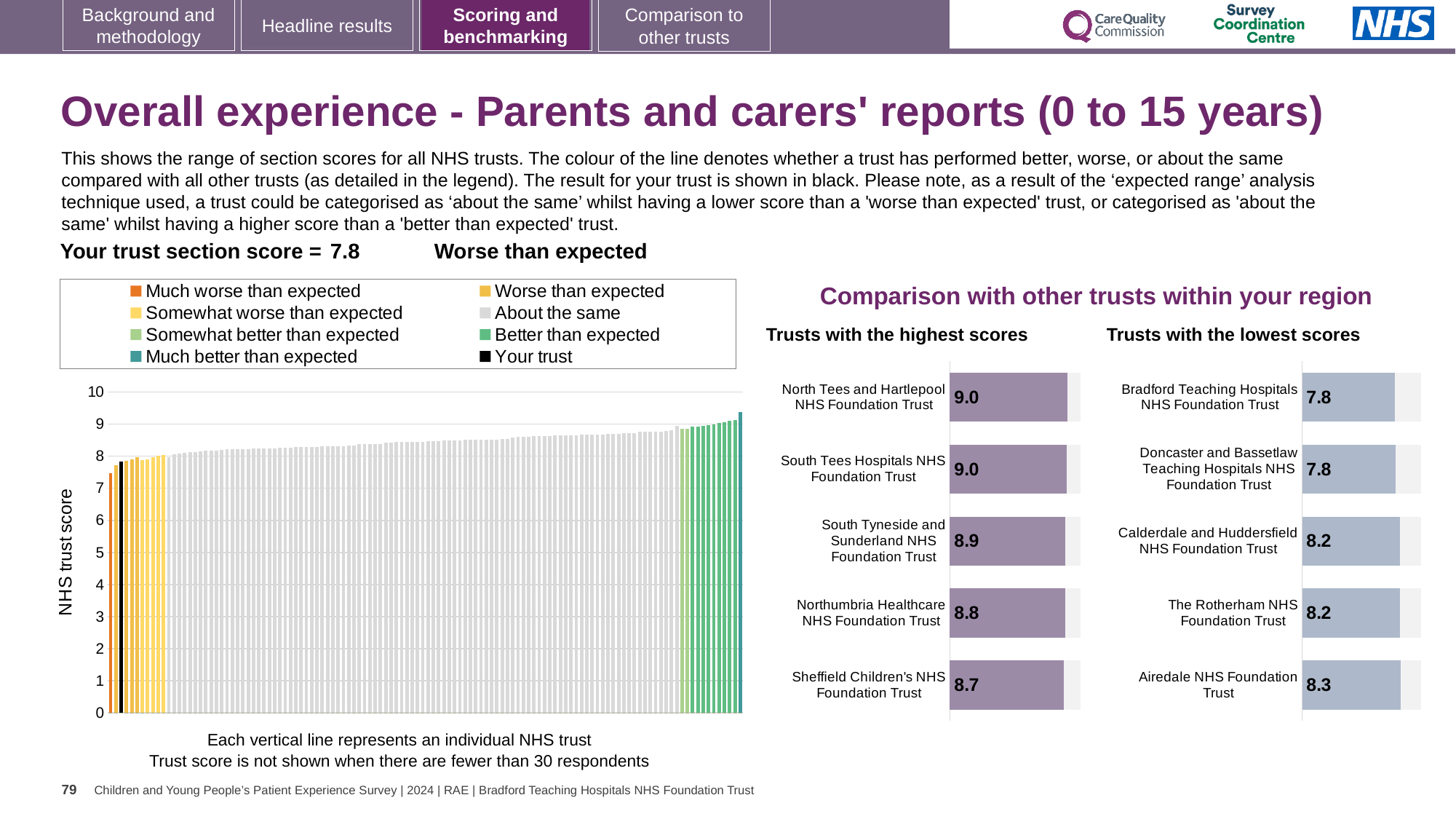
In the large chart on the left showing the range of section scores, is the value of the tallest bar greater or less than 9? greater In the 'Trusts with the lowest scores' chart, what is the difference between the scores of Airedale NHS Foundation Trust and Bradford Teaching Hospitals NHS Foundation Trust? 0.5 How many trusts are shown in the 'Trusts with the lowest scores' chart? 5 In the 'Trusts with the lowest scores' chart, which has the higher score: The Rotherham NHS Foundation Trust or Doncaster and Bassetlaw Teaching Hospitals NHS Foundation Trust? The Rotherham NHS Foundation Trust In the 'Trusts with the lowest scores' chart, what is the score for Calderdale and Huddersfield NHS Foundation Trust? 8.2 In the 'Trusts with the highest scores' chart, what is the score for Northumbria Healthcare NHS Foundation Trust? 8.8 In the 'Trusts with the highest scores' chart, what is the score for South Tyneside and Sunderland NHS Foundation Trust? 8.9 In the 'Trusts with the highest scores' chart, what is the difference between the scores of North Tees and Hartlepool NHS Foundation Trust and Sheffield Children's NHS Foundation Trust? 0.3 In the 'Trusts with the lowest scores' chart, which trust has the highest score? Airedale NHS Foundation Trust How many entries does the legend of the large chart on the left list? 8 In the 'Trusts with the highest scores' chart, which trust has the lowest score? Sheffield Children's NHS Foundation Trust What kind of chart is the large chart on the left showing the range of section scores for all NHS trusts? Bar chart